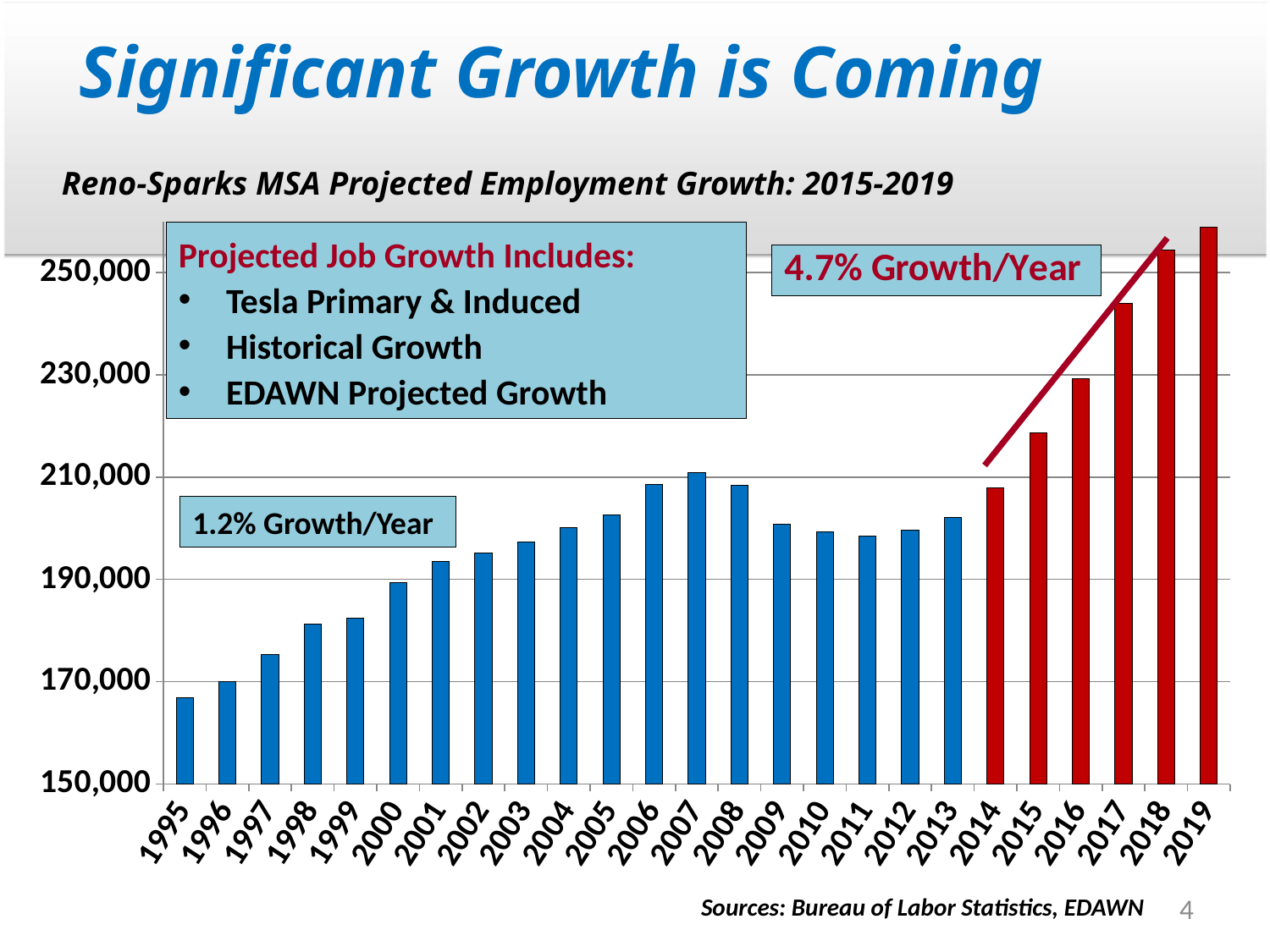
Do the values generally rise or fall from 2013 to 2019? rise Is the value for 2018 greater or less than 250,000? greater Is the value for 2014 greater or less than 200,000? greater Which year has the lowest employment value in the chart? 1995 Is the value for 2017 greater or less than 230,000? greater Which year has the highest employment value in the chart? 2019 How many years (bars) are plotted in the chart? 25 Which year has the larger value, 2007 or 2013? 2007 What kind of chart is shown on the slide? bar chart What annual growth rate is labelled for the projected (red) bars? 4.7% Growth/Year